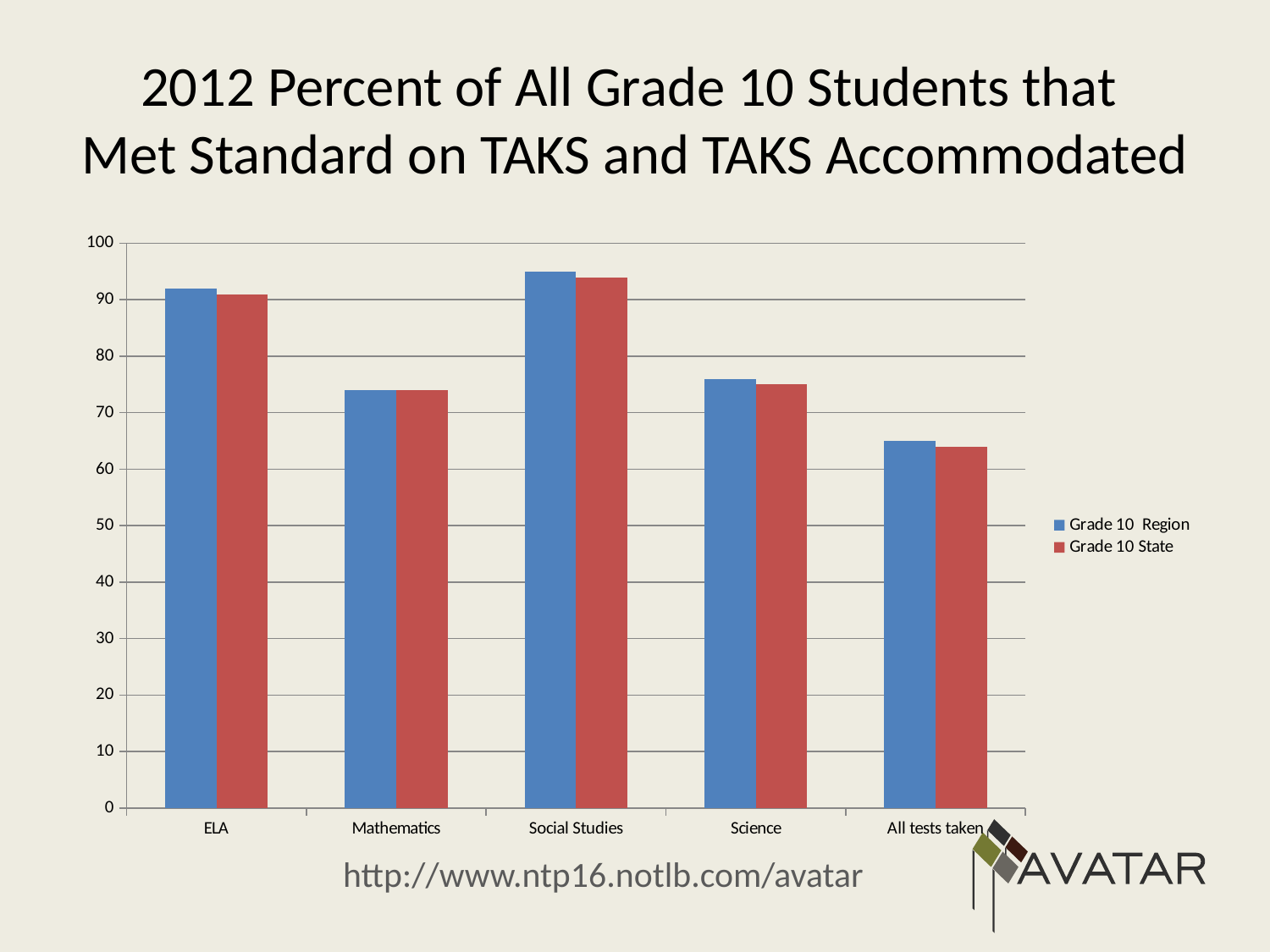
Is the Grade 10 Region value for All tests taken greater or less than 70? less Is the Grade 10 State value for Science greater or less than 70? greater Is the Grade 10 Region value for ELA greater or less than 90? greater Which is larger for Grade 10 Region: ELA or Mathematics? ELA How many series does the legend list? 2 Which category has the lowest value for Grade 10 State? All tests taken What colour are the Grade 10 State bars? red How many categories are shown on the x axis? 5 Which category has the highest value for Grade 10 Region? Social Studies What kind of chart is shown on the slide? bar chart Which is larger for Grade 10 State: Science or All tests taken? Science